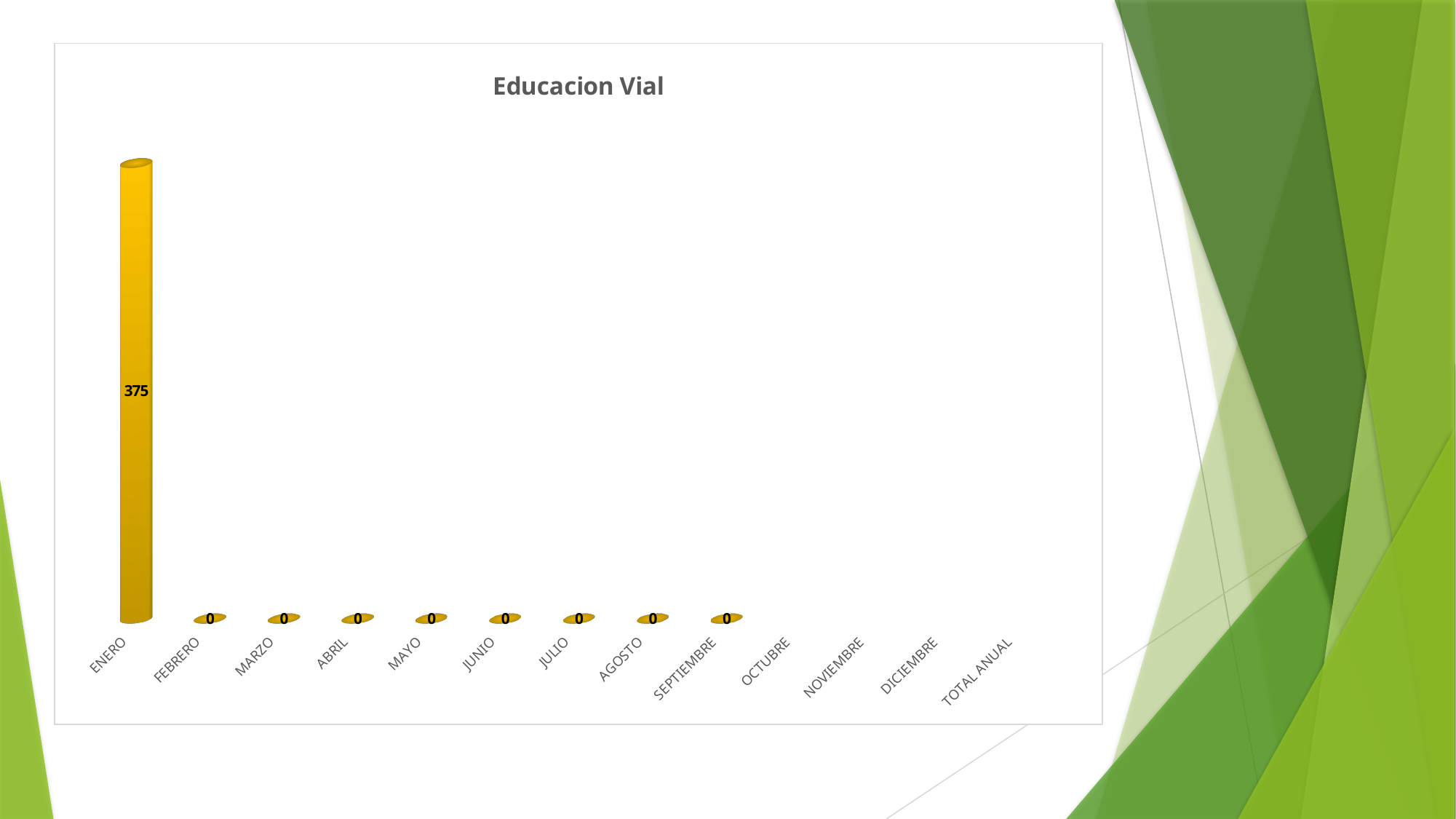
What is the title of the chart? Educacion Vial What kind of chart is shown on the slide? bar chart How many category labels are shown on the x axis? 13 Which month has the highest value? ENERO What is the value for SEPTIEMBRE? 0 What is the value for ENERO? 375 What is the value for FEBRERO? 0 What is the difference between the values for ENERO and MARZO? 375 What is the label of the last category on the x axis? TOTAL ANUAL Which is larger, the value for ENERO or the value for AGOSTO? ENERO What is the value for JUNIO? 0 How many categories have a data label of 0? 8